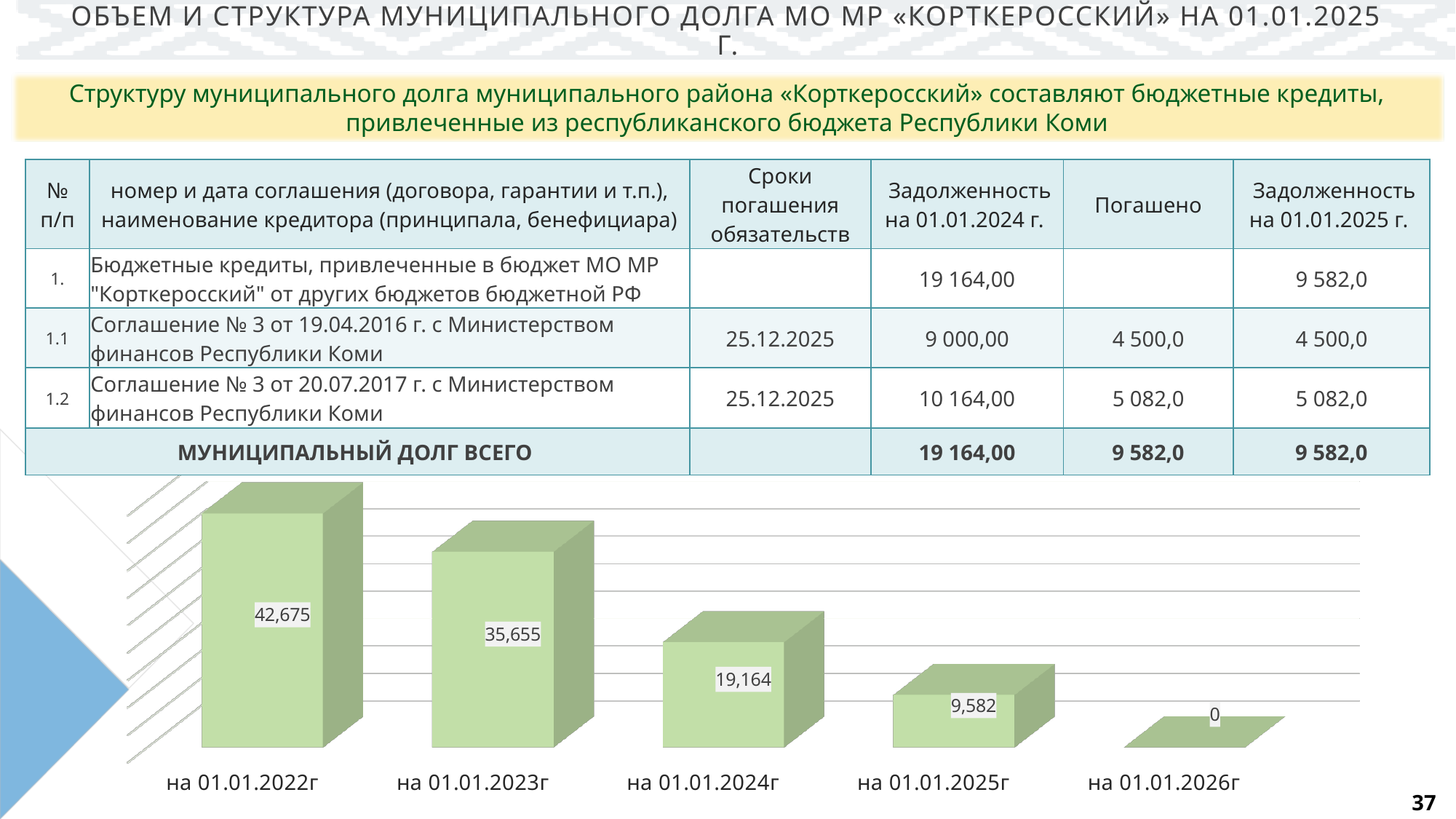
Do the values in the bar chart rise or fall from на 01.01.2022г to на 01.01.2026г? fall Which category has the highest value in the bar chart? на 01.01.2022г Which is larger in the bar chart: the value for на 01.01.2023г or the value for на 01.01.2024г? на 01.01.2023г What is the difference between the values for на 01.01.2022г and на 01.01.2023г in the bar chart? 7,020 What is the value shown for на 01.01.2024г in the bar chart? 19,164 What kind of chart is shown at the bottom of the slide? bar chart How many categories are shown on the x axis of the bar chart? 5 What is the value shown for на 01.01.2025г in the bar chart? 9,582 What is the value shown for на 01.01.2022г in the bar chart? 42,675 What is the value shown for на 01.01.2026г in the bar chart? 0 What is the difference between the values for на 01.01.2024г and на 01.01.2025г in the bar chart? 9,582 Which category has the lowest value in the bar chart? на 01.01.2026г